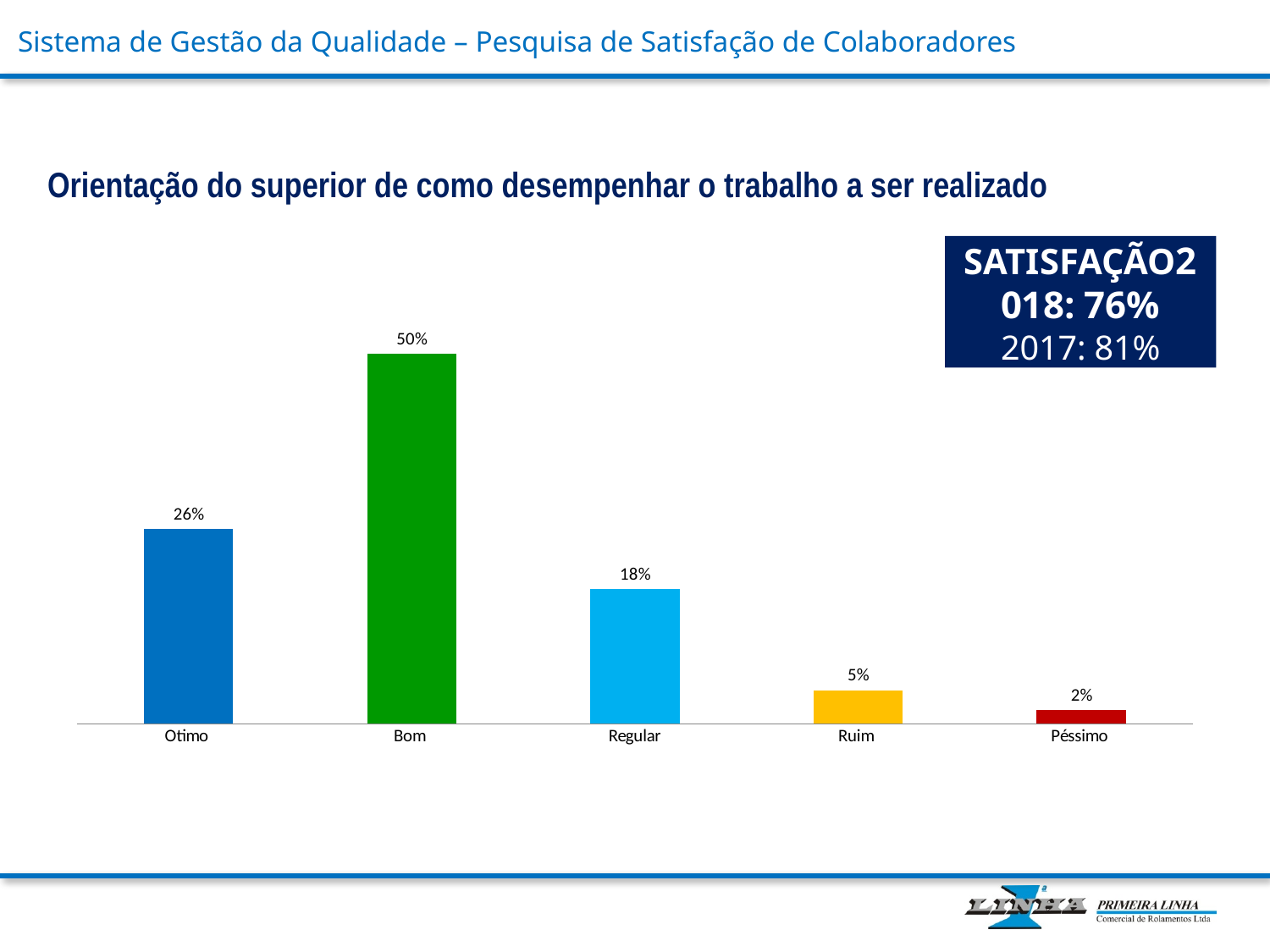
Which is larger, the value for Regular or the value for Ruim? Regular What kind of chart is shown on the slide? Bar chart What is the value for Ruim? 5% What is the value for Péssimo? 2% What is the value for Bom? 50% What colour is the bar for Bom? Green Which category has the highest value? Bom What is the difference between the values for Bom and Otimo? 24% What is the value for Regular? 18% Which category has the lowest value? Péssimo How many categories are shown on the x axis? 5 What is the value for Otimo? 26%